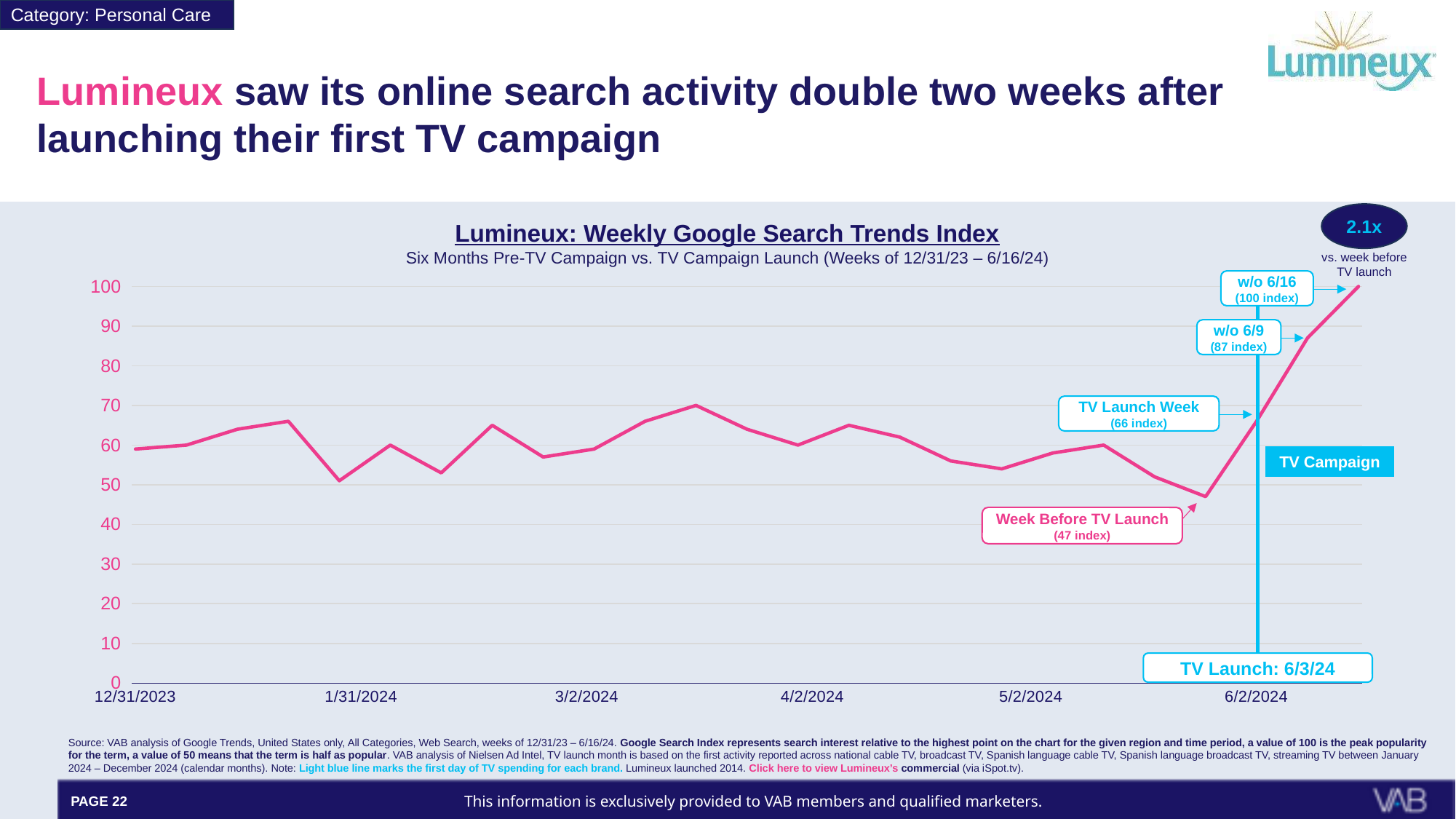
What index value is shown for the TV Launch Week? 66 By how much did the index rise from the week before the TV launch to the week of 6/16? 53 What index value is shown for the week of 6/16? 100 What index value is shown for the week of 6/9? 87 Which week has the highest index value on the chart? w/o 6/16 Is the index value at 12/31/2023 greater or less than 50? greater What is the difference between the index for the week of 6/9 and the TV Launch Week? 21 Does the index rise or fall in the weeks after the TV launch? rise Which is higher: the index for the TV Launch Week or the week before the TV launch? TV Launch Week What was the Google Search Trends Index value for the week before the TV launch? 47 What is the title of the chart? Lumineux: Weekly Google Search Trends Index What kind of chart is shown on the slide? line chart